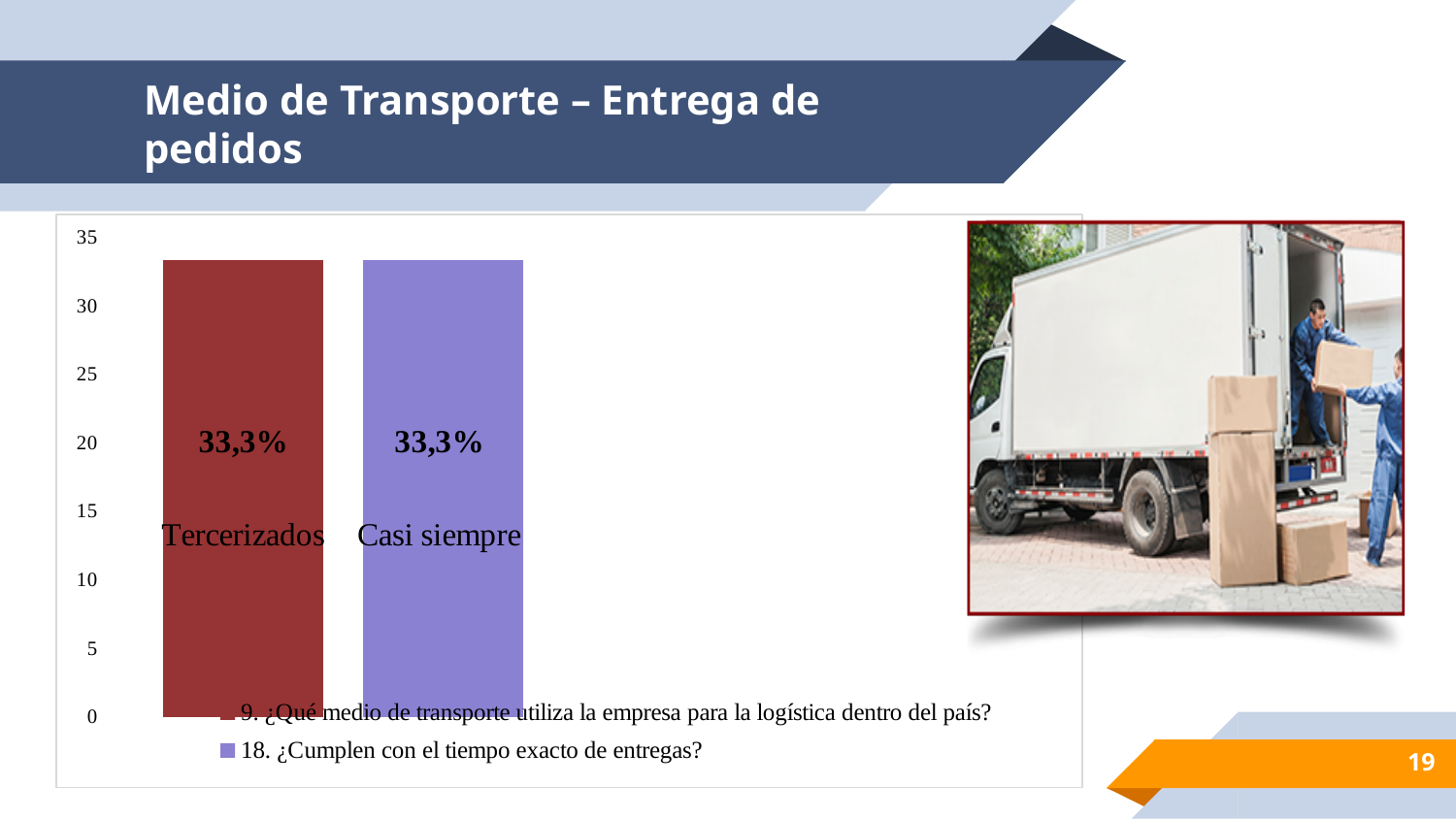
Do the Tercerizados and Casi siempre bars show the same value? Yes Which legend entry corresponds to the purple bar? 18. ¿Cumplen con el tiempo exacto de entregas? How many bars are plotted in the chart? 2 How many series does the legend list? 2 What value is shown on the Casi siempre bar? 33,3% What value is shown on the Tercerizados bar? 33,3% Is the value for Casi siempre greater or less than 35? less What kind of chart is shown on the slide? Bar chart What is the title of the slide containing the chart? Medio de Transporte – Entrega de pedidos What is the difference between the Tercerizados value and the Casi siempre value? 0% Is the value for Tercerizados greater or less than 30? greater